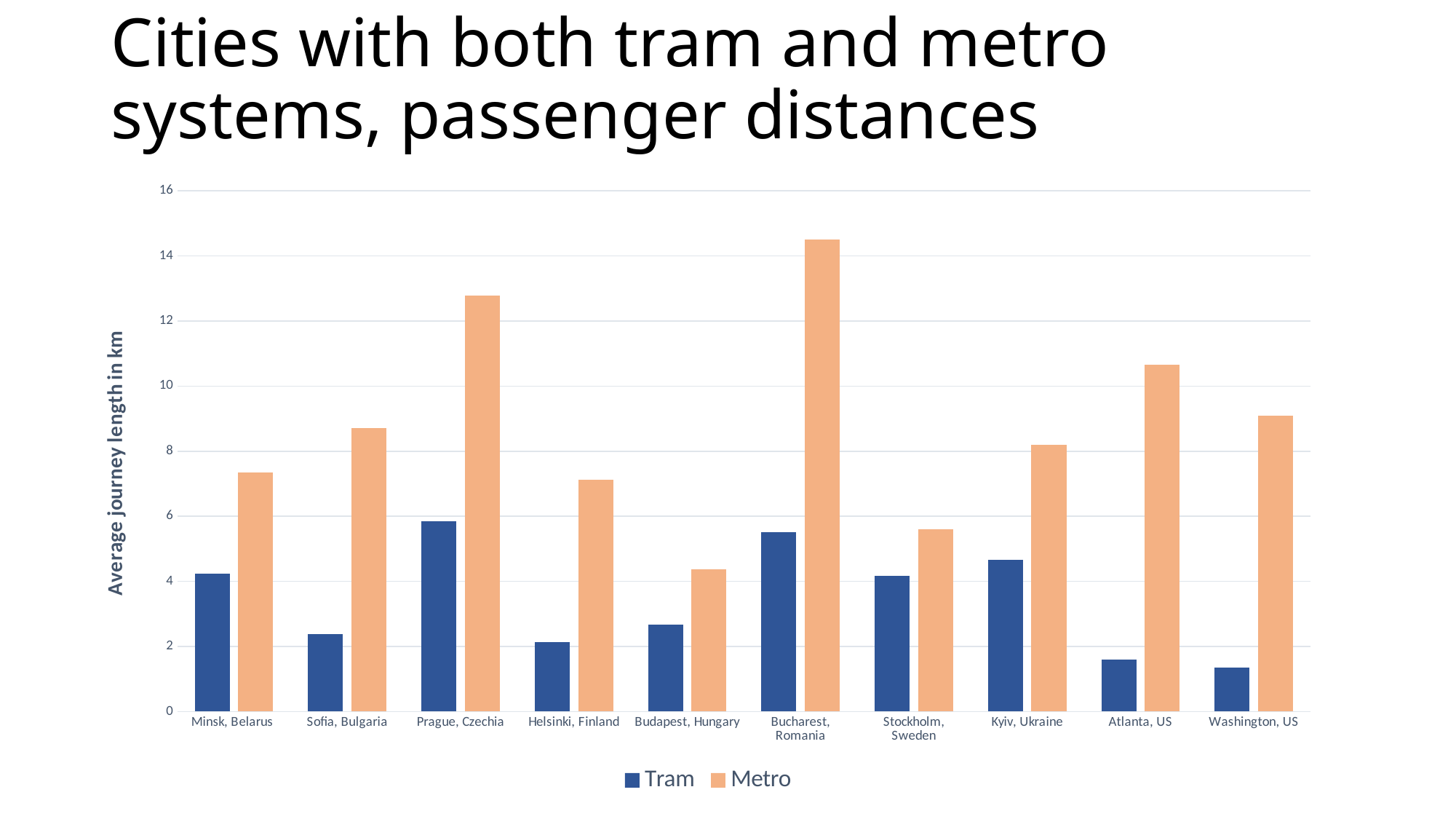
Is the Metro value for Prague, Czechia greater or less than 12? greater Which city has the lowest Metro average journey length? Budapest, Hungary Is the Metro value for Bucharest, Romania greater or less than 14? greater Which city has the highest Metro average journey length? Bucharest, Romania How many series does the legend list? 2 Is the Tram value for Washington, US greater or less than 2? less What is the label of the vertical axis? Average journey length in km Which city has the larger Metro value: Sofia, Bulgaria or Helsinki, Finland? Sofia, Bulgaria How many cities are shown on the x axis? 10 What kind of chart is shown on the slide? bar chart Which is larger for Atlanta, US: the Tram value or the Metro value? Metro